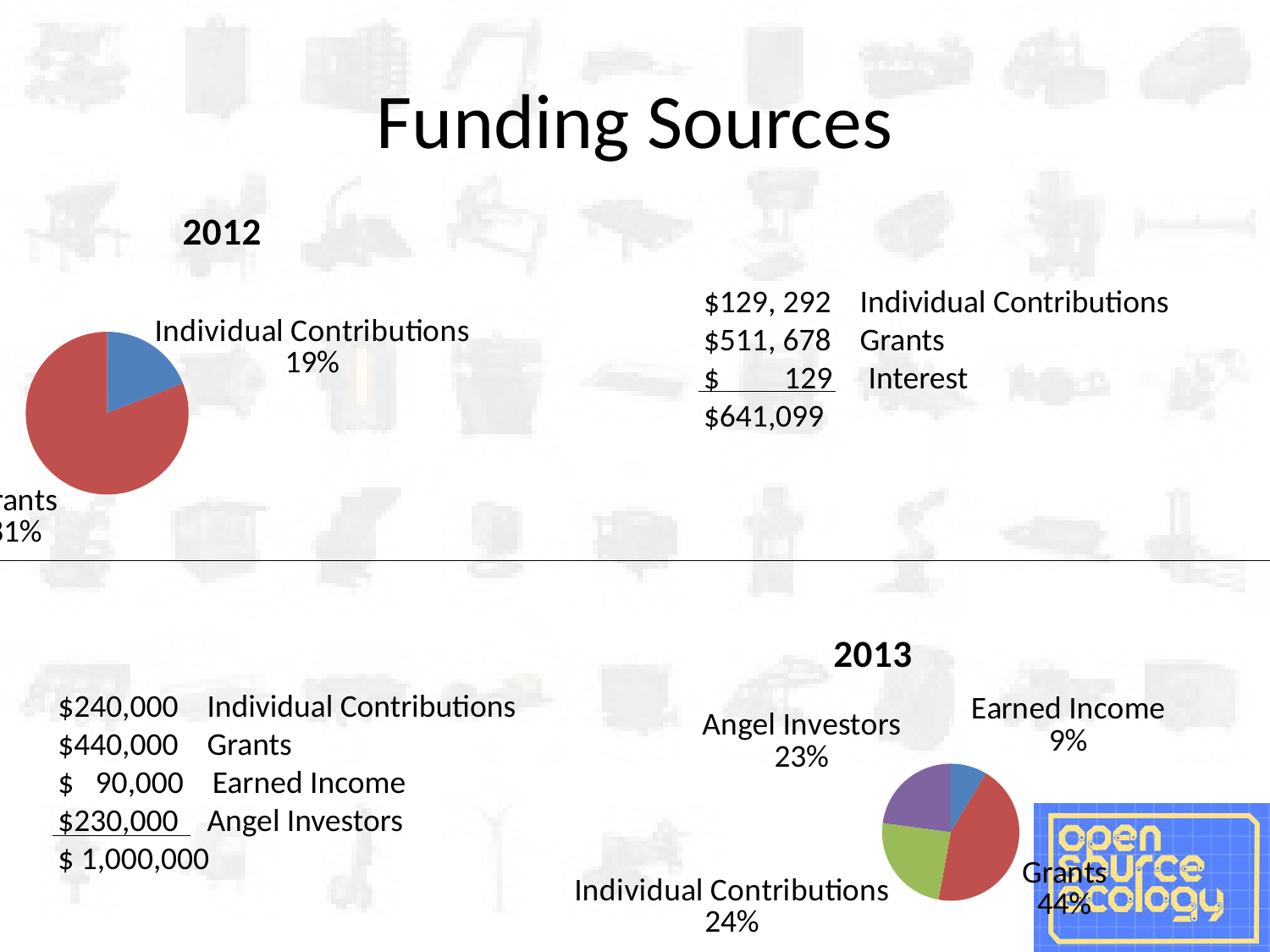
In the 2012 pie chart, what share of funding came from Individual Contributions? 19% In the 2012 pie chart, which funding source has the largest slice? Grants In the 2013 pie chart, which funding source has the largest slice? Grants In the 2013 pie chart, what share of funding came from Individual Contributions? 24% In the 2013 pie chart, what share of funding came from Grants? 44% How many slices does the 2013 pie chart have? 4 In the 2013 pie chart, which funding source has the smallest slice? Earned Income How many slices does the 2012 pie chart have? 2 In the 2013 pie chart, how many percentage points larger is the Grants share than the Angel Investors share? 21 percentage points What kind of chart is used to show the 2013 funding sources? Pie chart